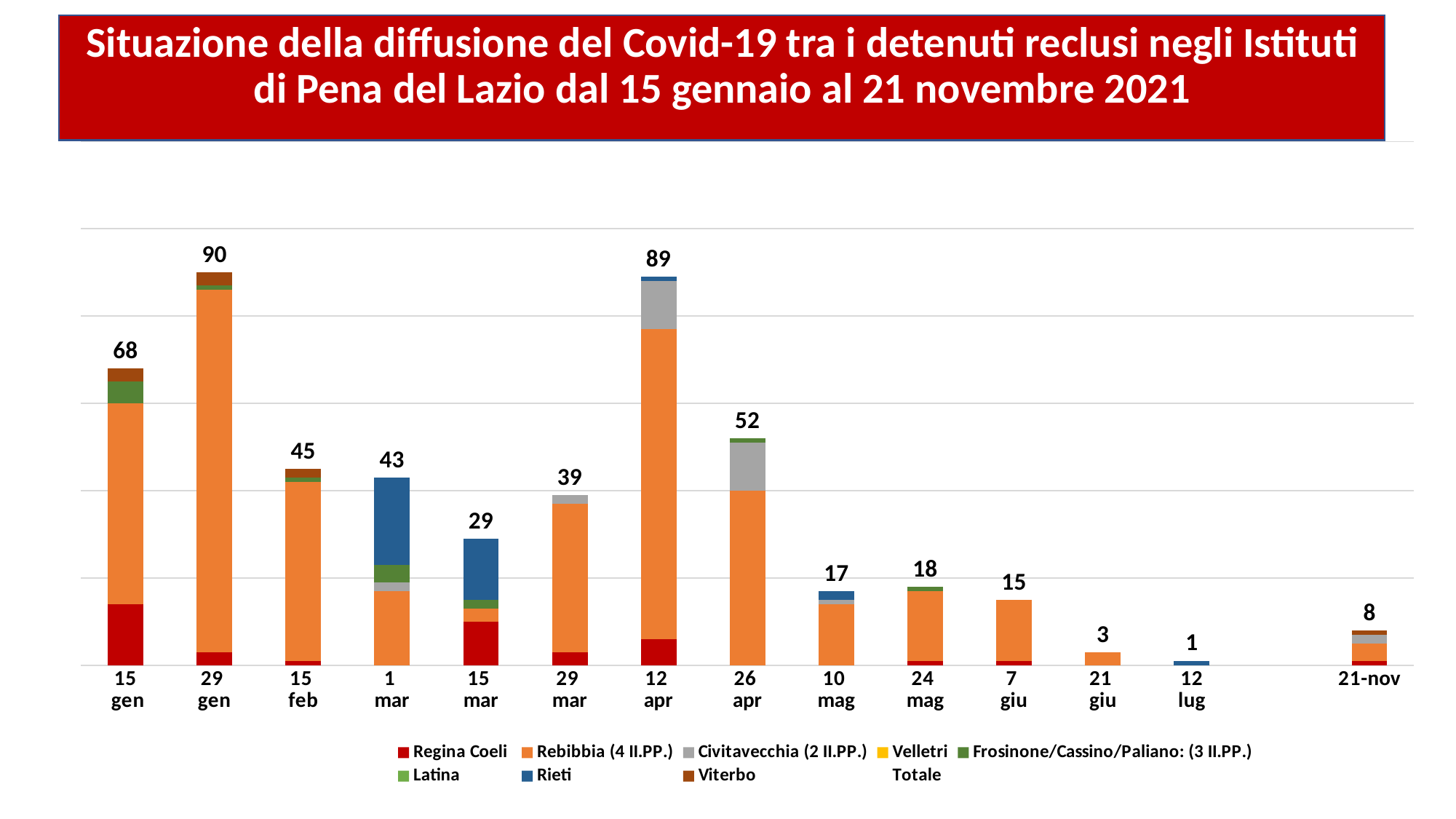
Which has a larger total, 1 mar or 29 mar? 1 mar Which date has the lowest total? 12 lug What is the difference between the totals for 29 gen and 15 gen? 22 What kind of chart is shown on the slide? Stacked bar chart How many dates are shown on the x axis? 14 Which date has the highest total? 29 gen What is the total value shown for 29 gen? 90 What is the total value shown for 12 apr? 89 What is the total value shown for 21-nov? 8 How many entries does the legend list? 9 What is the difference between the totals for 12 apr and 26 apr? 37 Do the totals rise or fall from 12 apr to 12 lug? Fall